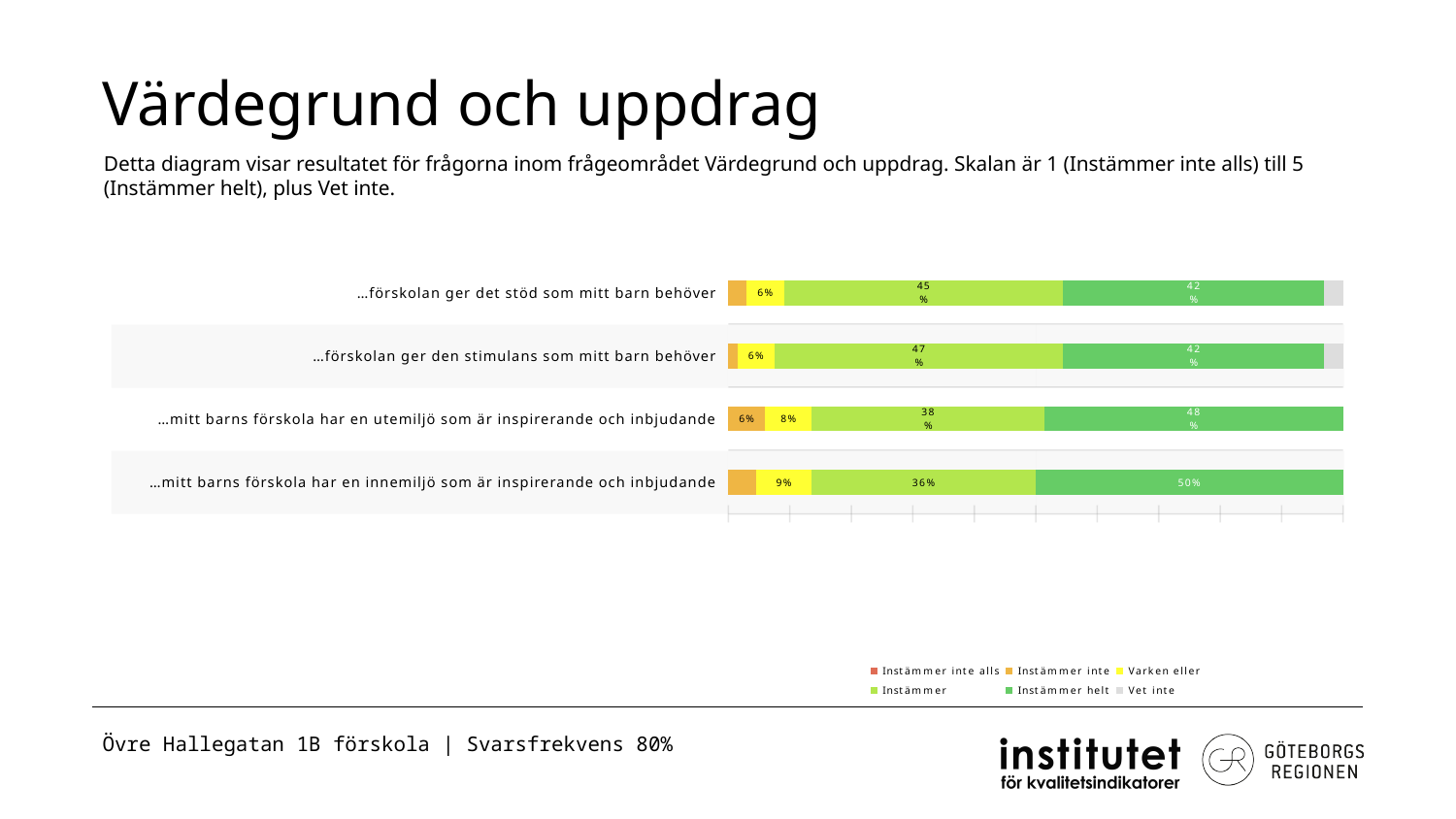
What is the Instämmer value for "…förskolan ger den stimulans som mitt barn behöver"? 47% How many series does the legend list? 6 What is the difference between the Instämmer helt values for "…mitt barns förskola har en utemiljö som är inspirerande och inbjudande" and "…förskolan ger det stöd som mitt barn behöver"? 6% What is the Instämmer helt value for "…mitt barns förskola har en innemiljö som är inspirerande och inbjudande"? 50% Which legend entry is shown in grey? Vet inte Which is larger: the Instämmer value for "…förskolan ger den stimulans som mitt barn behöver" or for "…mitt barns förskola har en utemiljö som är inspirerande och inbjudande"? …förskolan ger den stimulans som mitt barn behöver What kind of chart is shown on the slide? Stacked bar chart How many categories (questions) are plotted in the chart? 4 Which category has the highest Instämmer helt value? …mitt barns förskola har en innemiljö som är inspirerande och inbjudande Which category has the lowest Instämmer value? …mitt barns förskola har en innemiljö som är inspirerande och inbjudande What is the Varken eller value for "…mitt barns förskola har en utemiljö som är inspirerande och inbjudande"? 8% What is the Instämmer value for "…förskolan ger det stöd som mitt barn behöver"? 45%